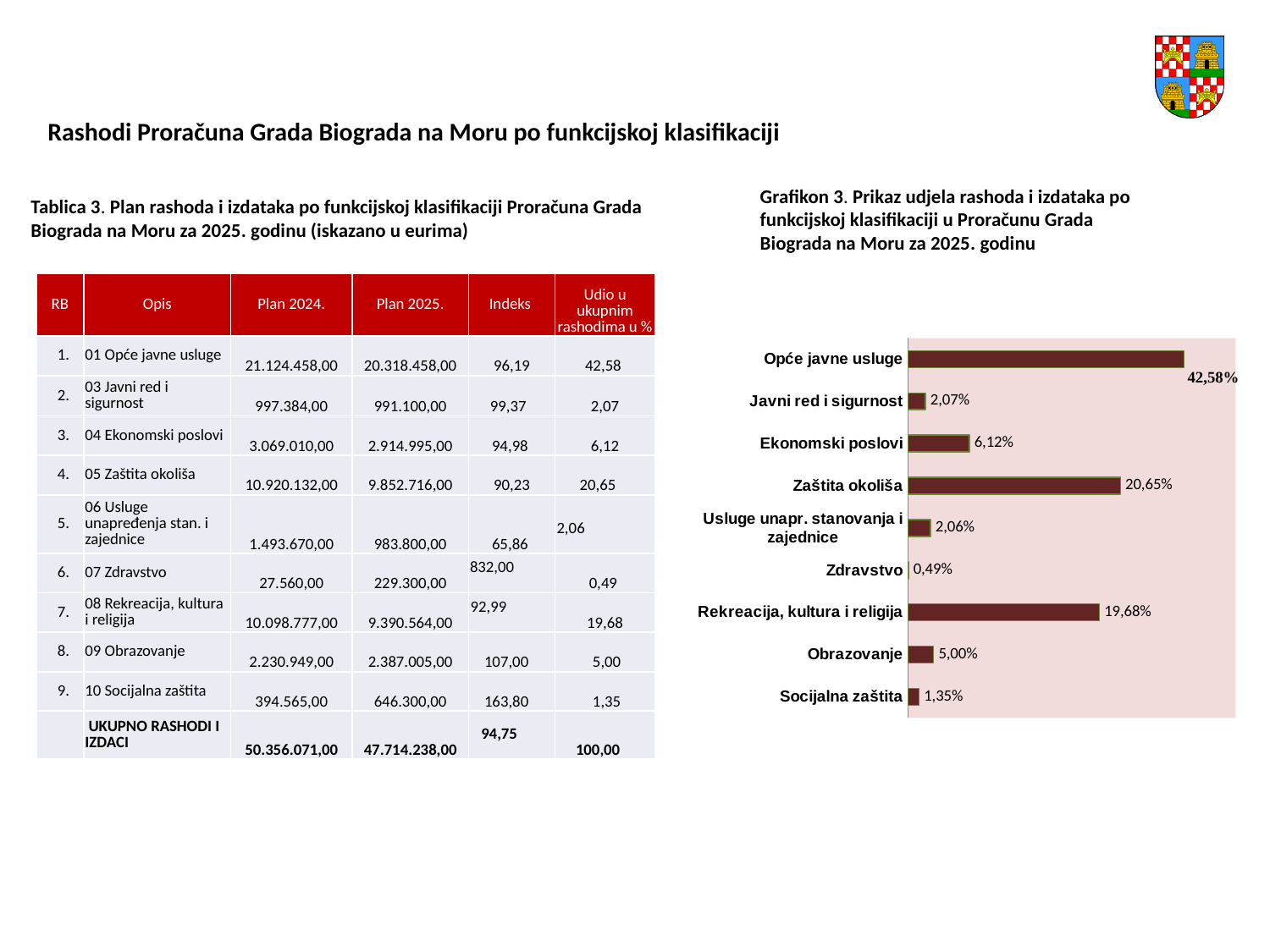
What is the difference between the values for Zaštita okoliša and Rekreacija, kultura i religija? 0,97% What is the title of the chart? Grafikon 3. Prikaz udjela rashoda i izdataka po funkcijskoj klasifikaciji u Proračunu Grada Biograda na Moru za 2025. godinu What is the value shown for Zdravstvo? 0,49% Which is larger, the value for Ekonomski poslovi or the value for Obrazovanje? Ekonomski poslovi Which category has the highest value in the chart? Opće javne usluge What is the value shown for Socijalna zaštita? 1,35% What type of chart is shown on the slide? bar chart Which category has the lowest value in the chart? Zdravstvo What is the value shown for Zaštita okoliša? 20,65% What is the value shown for Opće javne usluge? 42,58% What is the value shown for Rekreacija, kultura i religija? 19,68% How many categories are plotted in the chart? 9